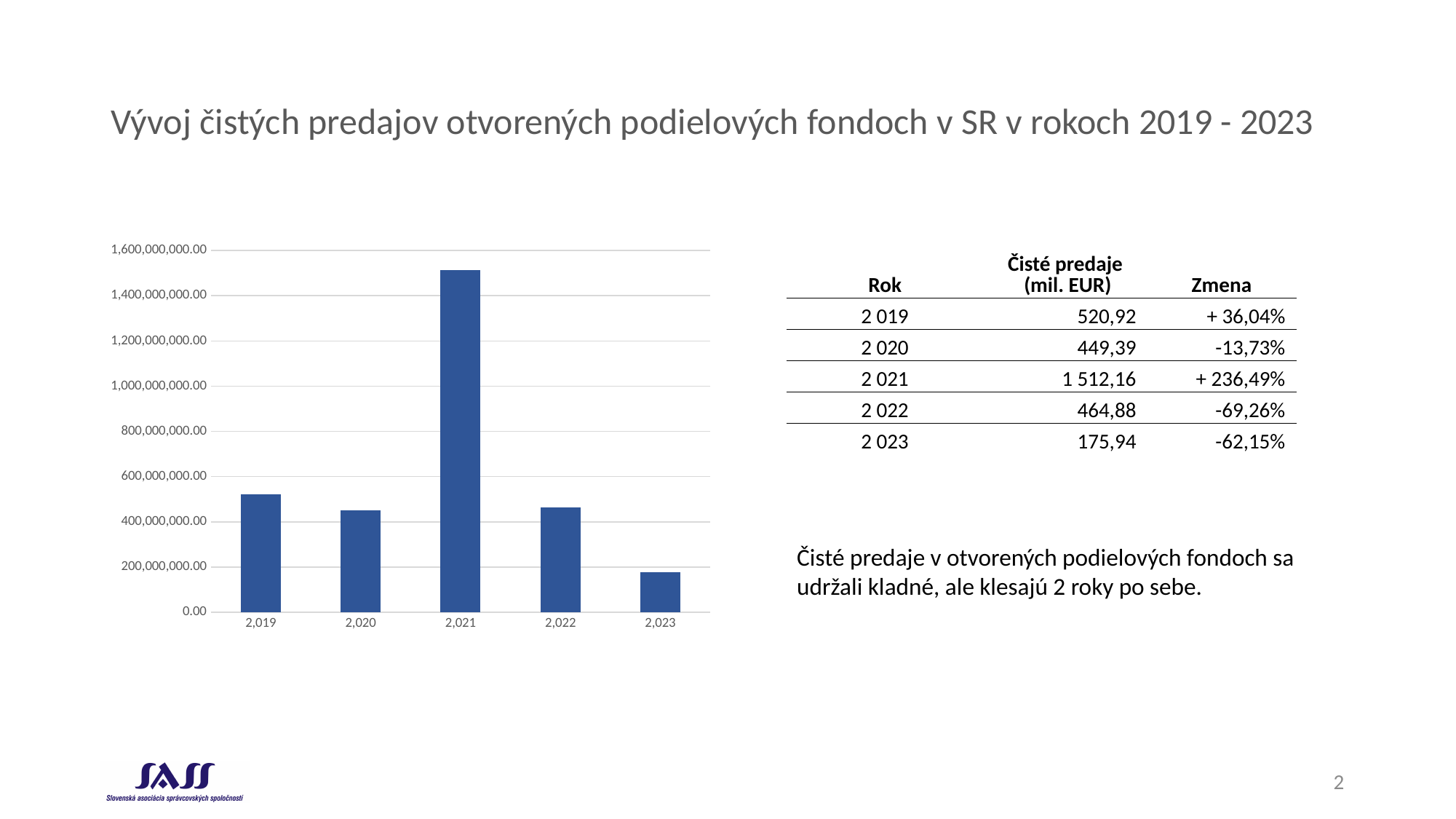
Which bar is taller, 2,021 or 2,019? 2,021 Which year has the highest bar in the chart? 2,021 Is the value for 2,021 greater or less than 1,400,000,000.00? greater Which year has the lowest bar in the chart? 2,023 What kind of chart is shown on the slide? bar chart How many years (bars) are plotted in the chart? 5 Do the bar values rise or fall from 2,021 to 2,023? fall Is the value for 2,019 greater or less than 400,000,000.00? greater What is the highest value shown on the chart's vertical axis? 1,600,000,000.00 Is the value for 2,022 greater or less than 600,000,000.00? less Which bar is taller, 2,019 or 2,020? 2,019